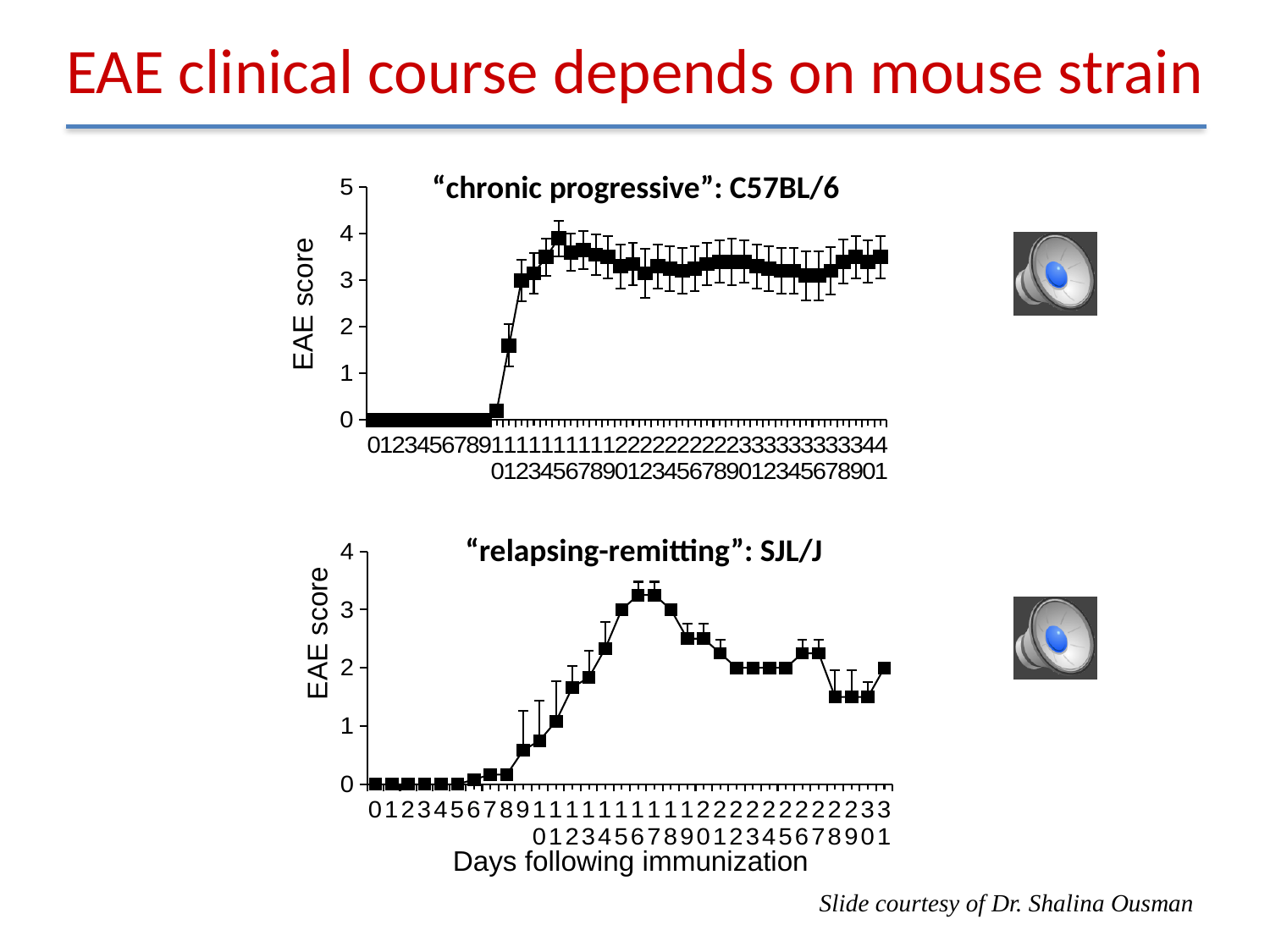
In the top chart ("chronic progressive": C57BL/6), what is the EAE score at day 5? 0 In the top chart ("chronic progressive": C57BL/6), is the highest EAE score greater or less than 3? greater In the bottom chart ("relapsing-remitting": SJL/J), which is larger: the peak EAE score or the EAE score on the last day? the peak EAE score What is the y-axis label of the bottom chart titled "relapsing-remitting": SJL/J? EAE score How many charts are shown on the slide? 2 In the bottom chart ("relapsing-remitting": SJL/J), is the highest EAE score greater or less than 3? greater In the top chart ("chronic progressive": C57BL/6), do the EAE scores rise or fall between day 10 and day 15? rise In the bottom chart ("relapsing-remitting": SJL/J), what is the EAE score at day 3? 0 What kind of chart is the top chart titled "chronic progressive": C57BL/6? line chart What is the x-axis label shown below the bottom chart? Days following immunization In the bottom chart ("relapsing-remitting": SJL/J), is the EAE score at the last day greater or less than 3? less In the bottom chart ("relapsing-remitting": SJL/J), do the EAE scores rise or fall between day 17 and day 22? fall